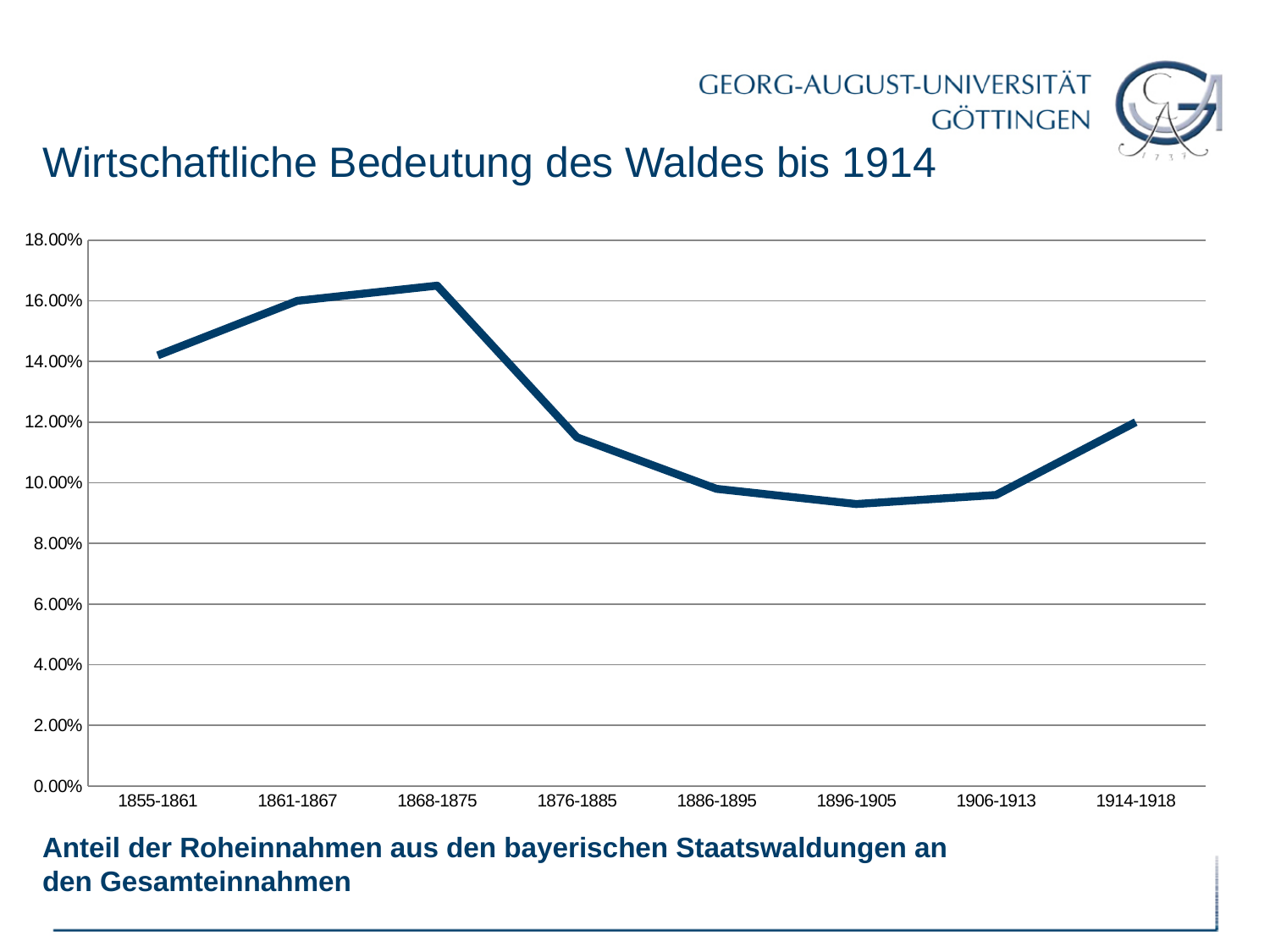
Which period has the highest value? 1868-1875 What kind of chart is shown on the slide? line chart How many time periods are plotted along the x axis? 8 Do the values rise or fall from 1868-1875 to 1896-1905? fall Do the values rise or fall from 1855-1861 to 1868-1875? rise Is the value for 1914-1918 greater or less than 10.00%? greater Is the value for 1855-1861 greater or less than 16.00%? less Which is larger, the value for 1855-1861 or the value for 1876-1885? 1855-1861 Is the value for 1868-1875 greater or less than 16.00%? greater What is the first period shown on the x axis? 1855-1861